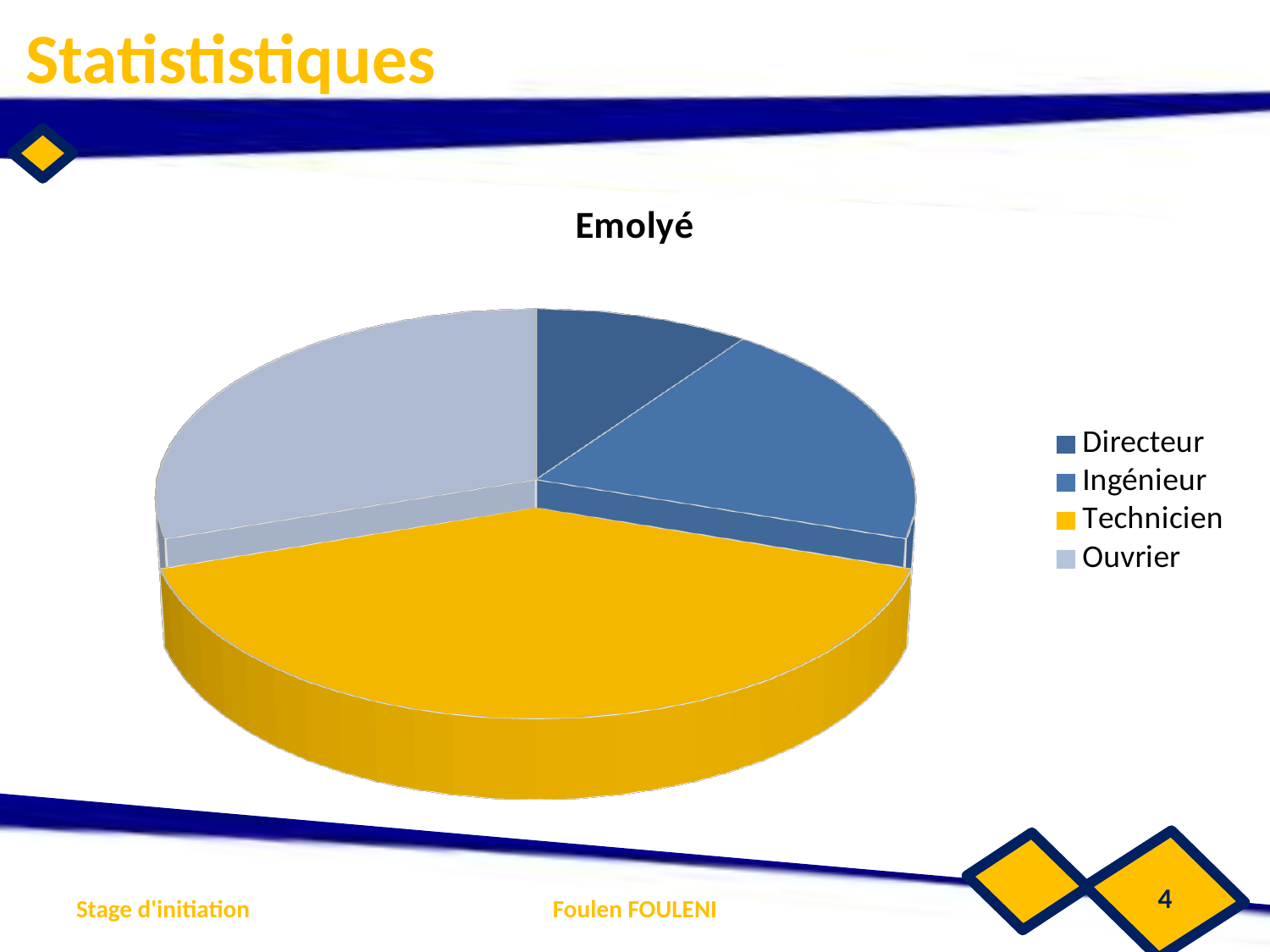
Which category has the smallest slice of the pie? Directeur How many entries does the legend list? 4 What kind of chart is shown on the slide? pie chart Which slice is larger, Technicien or Ouvrier? Technicien How many categories (slices) does the pie chart have? 4 Which category has the largest slice of the pie? Technicien What is the title of the chart? Emolyé Which slice is larger, Technicien or Directeur? Technicien Which category is shown in yellow in the pie chart? Technicien Which slice is larger, Ingénieur or Directeur? Ingénieur Which legend entry is listed first? Directeur